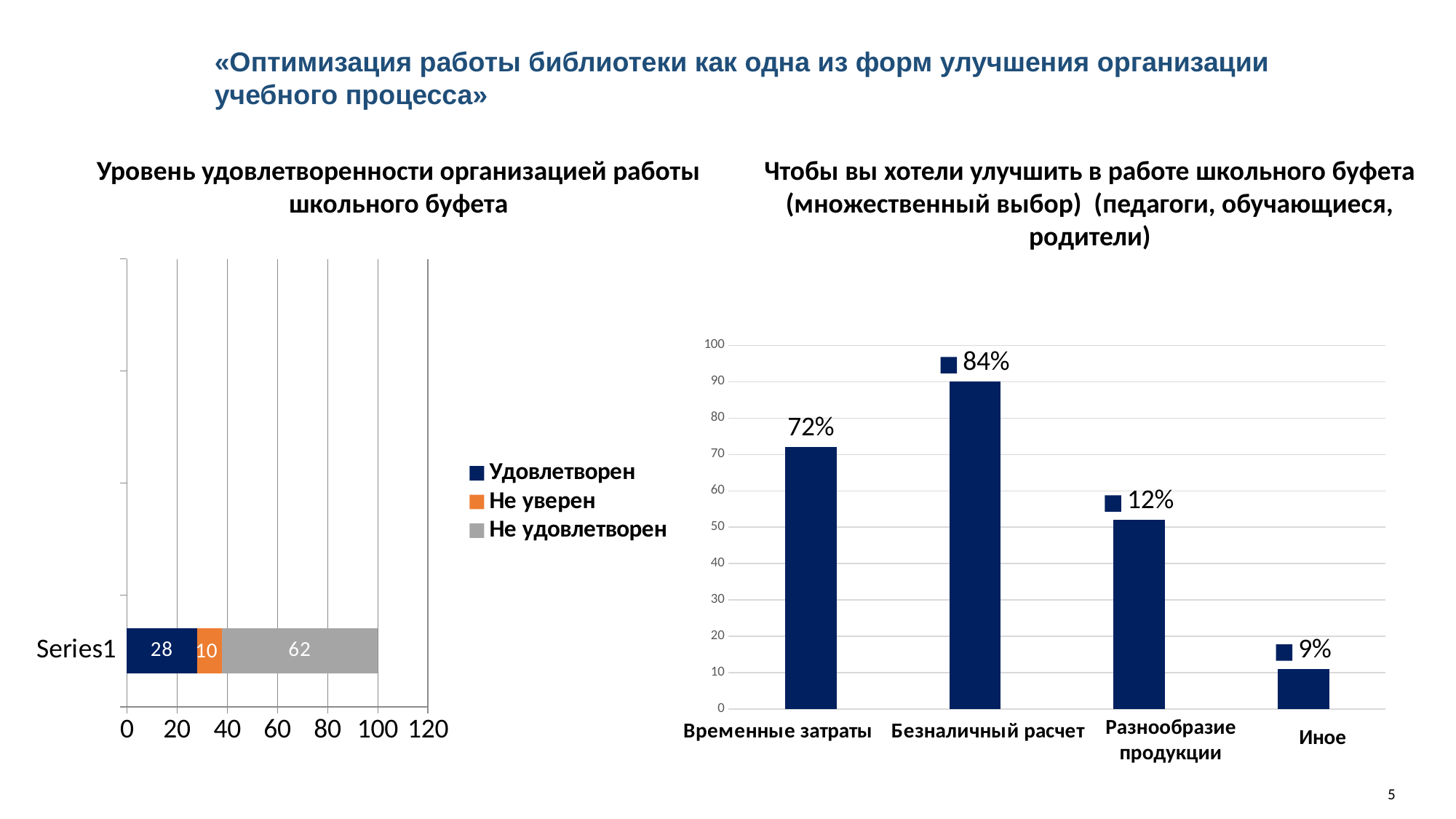
In the chart 'Чтобы вы хотели улучшить в работе школьного буфета', what is the value for 'Иное'? 9% In the chart 'Уровень удовлетворенности организацией работы школьного буфета', what is the total of the stacked bar? 100 In the chart 'Чтобы вы хотели улучшить в работе школьного буфета', what is the value for 'Безналичный расчет'? 84% In the chart 'Уровень удовлетворенности организацией работы школьного буфета', what is the value for 'Удовлетворен'? 28 In the chart 'Уровень удовлетворенности организацией работы школьного буфета', which series has the largest value? Не удовлетворен In the chart 'Уровень удовлетворенности организацией работы школьного буфета', what is the difference between 'Не удовлетворен' and 'Удовлетворен'? 34 In the chart 'Уровень удовлетворенности организацией работы школьного буфета', what is the value for 'Не уверен'? 10 In the chart 'Уровень удовлетворенности организацией работы школьного буфета', how many series does the legend list? 3 In the chart 'Уровень удовлетворенности организацией работы школьного буфета', what is the value for 'Не удовлетворен'? 62 In the chart 'Чтобы вы хотели улучшить в работе школьного буфета', which category has the lowest value? Иное What kind of chart is 'Чтобы вы хотели улучшить в работе школьного буфета'? Bar chart In the chart 'Чтобы вы хотели улучшить в работе школьного буфета', how many categories are shown? 4